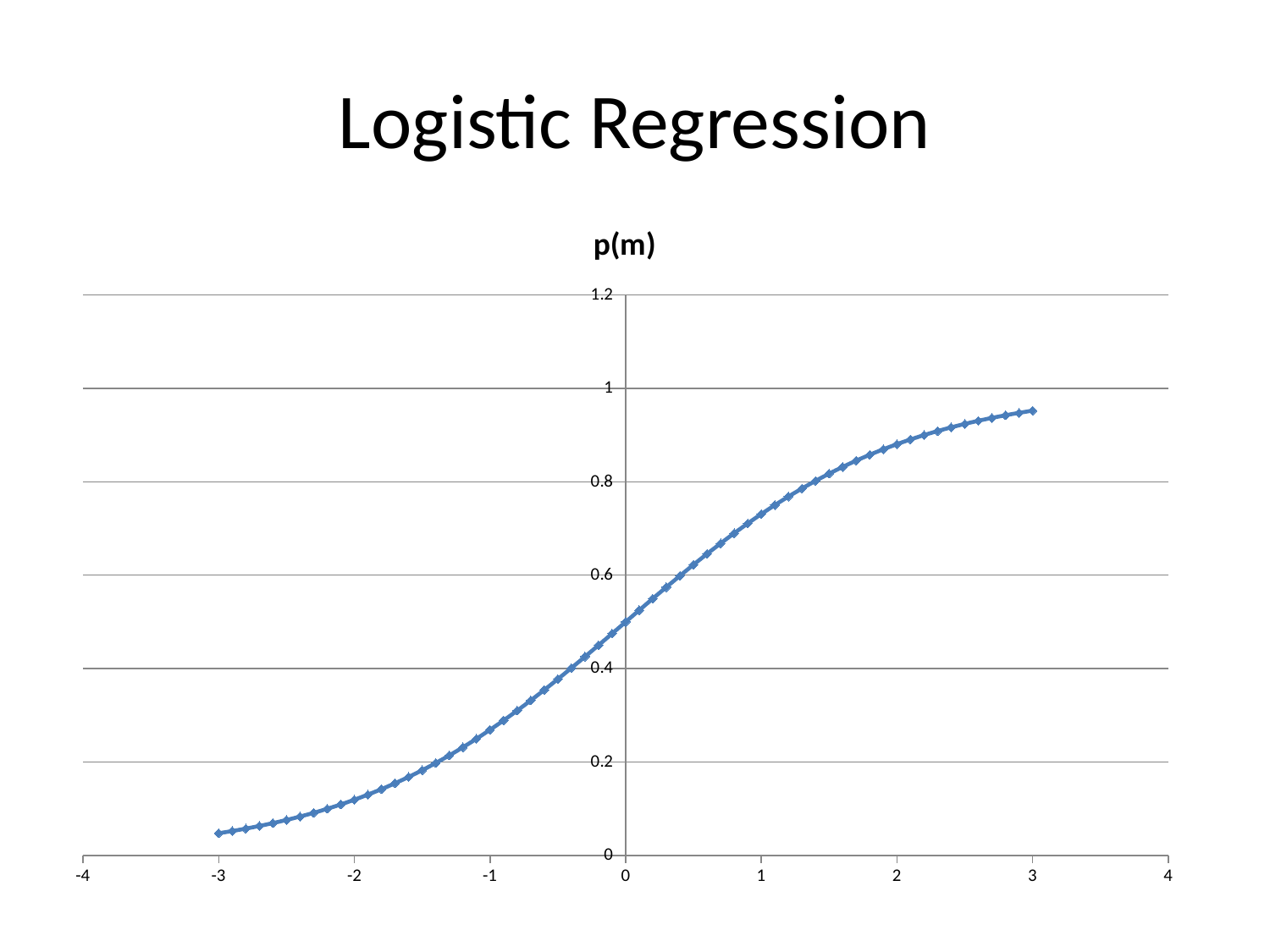
Is the value of p(m) at x = 1 greater or less than 0.6? greater Is the value of p(m) at x = 3 greater or less than 1? less Is the value of p(m) at x = 3 greater or less than 0.8? greater Which is larger, the value of p(m) at x = 2 or at x = -2? x = 2 At which x value does the plotted curve reach its highest point? 3 What kind of chart is shown on the slide? line chart Do the plotted values rise or fall as the x axis goes from -3 to 3? rise What is the title of the chart? p(m) At which x value does the plotted curve reach its lowest point? -3